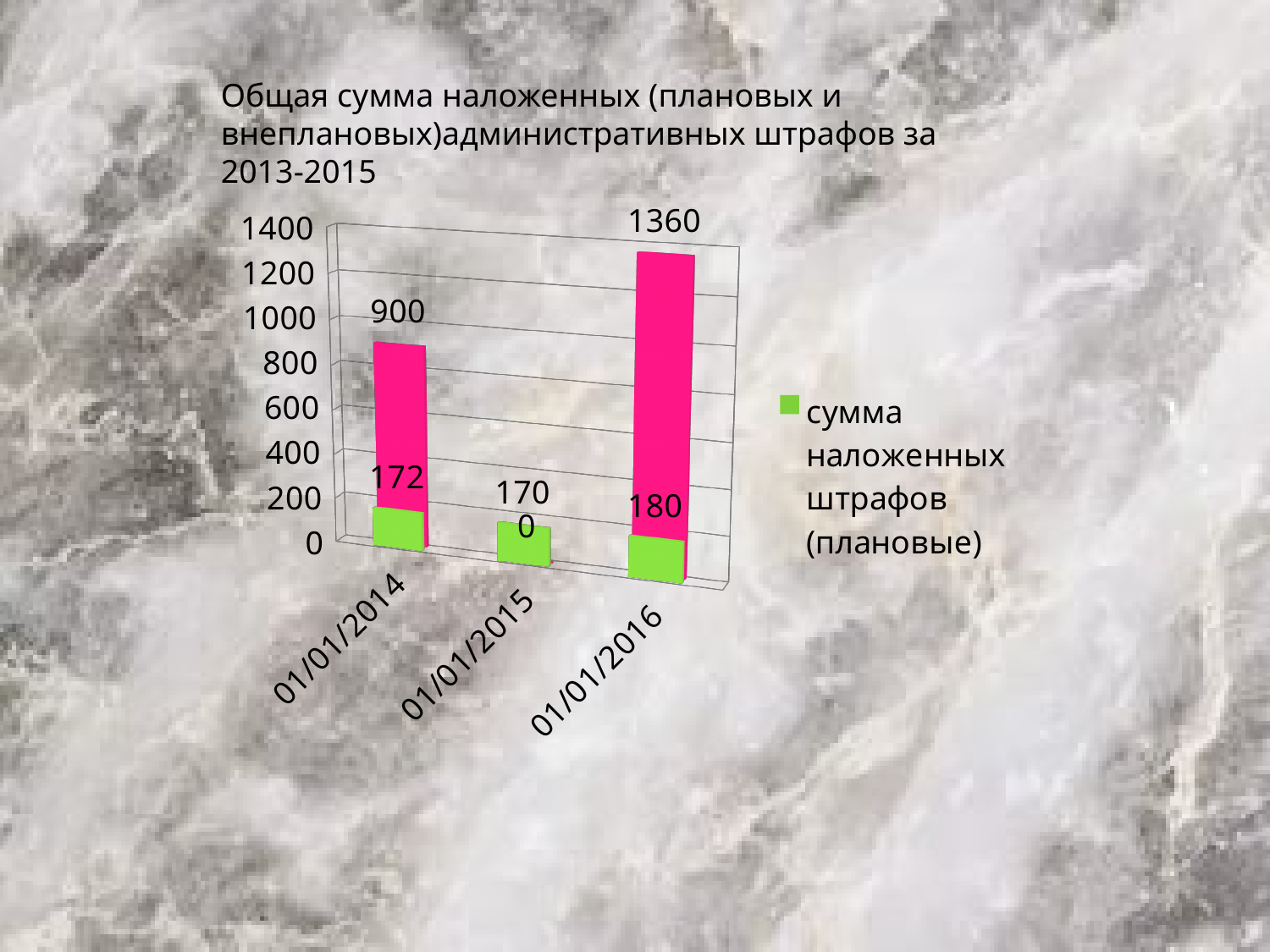
What kind of chart is shown on the slide? bar chart What is the value of the pink segment for 01/01/2015? 0 What is the value of the green series (сумма наложенных штрафов (плановые)) for 01/01/2014? 172 What is the value of the green series for 01/01/2015? 170 How many series does the legend list? 1 Which is larger: the green series value for 01/01/2016 or for 01/01/2014? 01/01/2016 What is the difference between the pink segment values for 01/01/2016 and 01/01/2014? 460 What is the difference between the green series values for 01/01/2016 and 01/01/2015? 10 How many categories are shown on the x axis? 3 Which category has the highest pink segment value? 01/01/2016 What is the value of the pink segment for 01/01/2016? 1360 Which category has the lowest value for the green series (плановые)? 01/01/2015